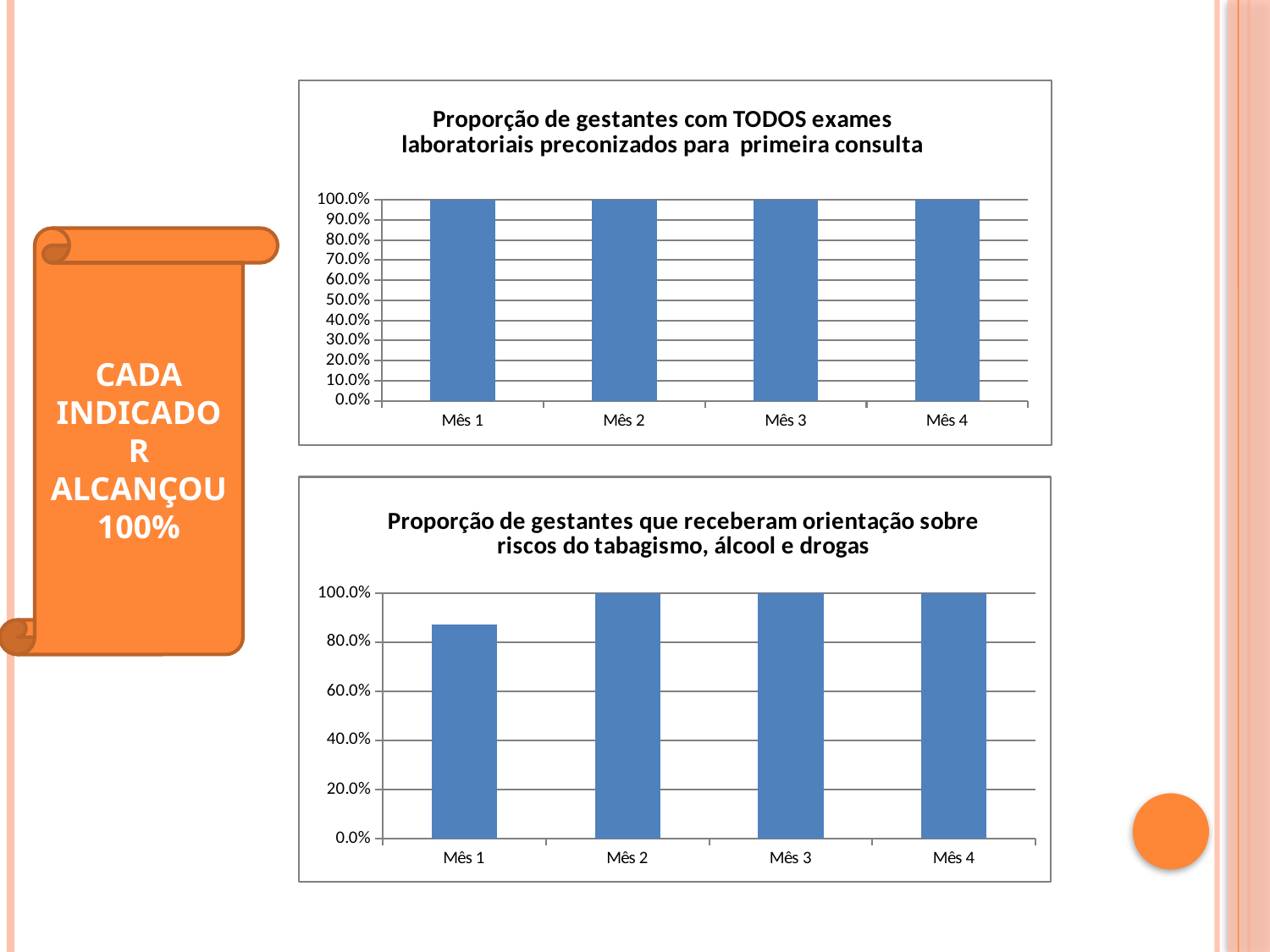
In the top chart (Proporção de gestantes com TODOS exames laboratoriais preconizados para primeira consulta), what is the value for Mês 4? 100.0% In the bottom chart (Proporção de gestantes que receberam orientação sobre riscos do tabagismo, álcool e drogas), how many bars are plotted? 4 In the bottom chart (Proporção de gestantes que receberam orientação sobre riscos do tabagismo, álcool e drogas), is the value for Mês 1 greater or less than 100.0%? less In the bottom chart (Proporção de gestantes que receberam orientação sobre riscos do tabagismo, álcool e drogas), is the value for Mês 1 greater or less than 80.0%? greater What is the title of the bottom chart on the slide? Proporção de gestantes que receberam orientação sobre riscos do tabagismo, álcool e drogas In the top chart (Proporção de gestantes com TODOS exames laboratoriais preconizados para primeira consulta), what is the value for Mês 1? 100.0% In the bottom chart (Proporção de gestantes que receberam orientação sobre riscos do tabagismo, álcool e drogas), what is the value for Mês 2? 100.0% In the bottom chart (Proporção de gestantes que receberam orientação sobre riscos do tabagismo, álcool e drogas), which month has the lowest value? Mês 1 In the top chart (Proporção de gestantes com TODOS exames laboratoriais preconizados para primeira consulta), how many categories are shown on the x axis? 4 In the bottom chart (Proporção de gestantes que receberam orientação sobre riscos do tabagismo, álcool e drogas), does the value rise or fall from Mês 1 to Mês 2? rise What kind of chart is the top chart on the slide? Bar chart In the bottom chart (Proporção de gestantes que receberam orientação sobre riscos do tabagismo, álcool e drogas), which is larger, the value for Mês 1 or the value for Mês 3? Mês 3